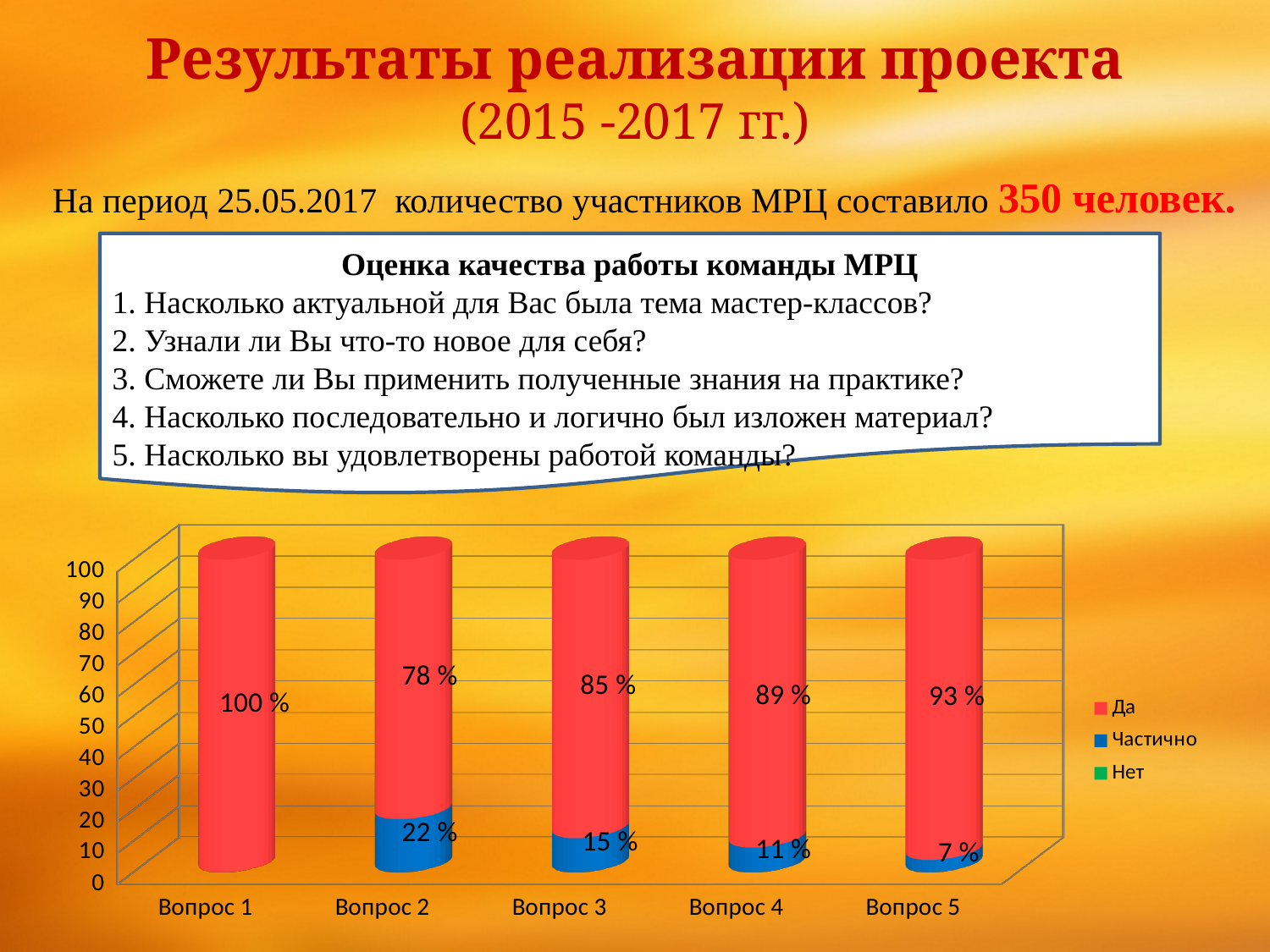
How many series does the chart legend list? 3 What is the value of the "Частично" series for Вопрос 4? 11 % How many questions (categories) are shown on the x axis of the chart? 5 What is the value of the "Да" series for Вопрос 2? 78 % What is the difference between the "Да" values for Вопрос 5 and Вопрос 2? 15 % What is the value of the "Да" series for Вопрос 5? 93 % Which question (category) has the highest value for the "Да" series? Вопрос 1 Which is larger: the "Частично" value for Вопрос 2 or for Вопрос 5? Вопрос 2 Do the "Да" values rise or fall from Вопрос 2 to Вопрос 5? Rise What kind of chart is shown on the slide? Stacked bar chart Which question (category) has the lowest value for the "Да" series? Вопрос 2 What is the value of the "Частично" series for Вопрос 3? 15 %